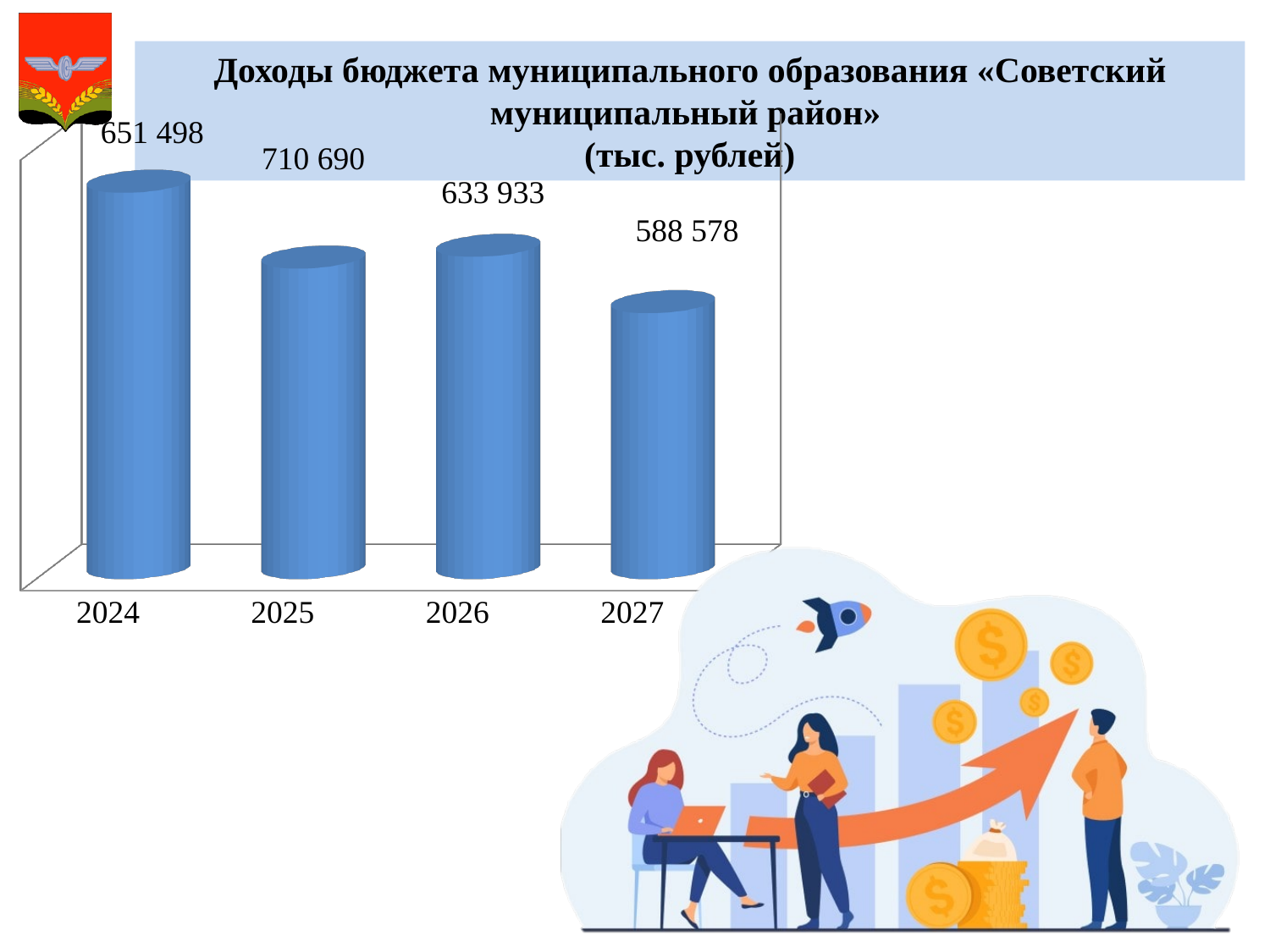
In what units are the values on the chart expressed, according to the title? тыс. рублей What kind of chart is shown on the slide? Bar chart How many years are shown on the chart? 4 What is the budget revenue value shown for 2026? 633 933 What is the difference between the values for 2024 and 2027? 62 920 What is the budget revenue value shown for 2025? 710 690 What is the budget revenue value shown for 2024? 651 498 What is the difference between the values for 2026 and 2027? 45 355 Which is larger, the value for 2026 or the value for 2027? 2026 Which year has the lowest budget revenue value on the chart? 2027 What is the budget revenue value shown for 2027? 588 578 Which is larger, the value for 2024 or the value for 2027? 2024